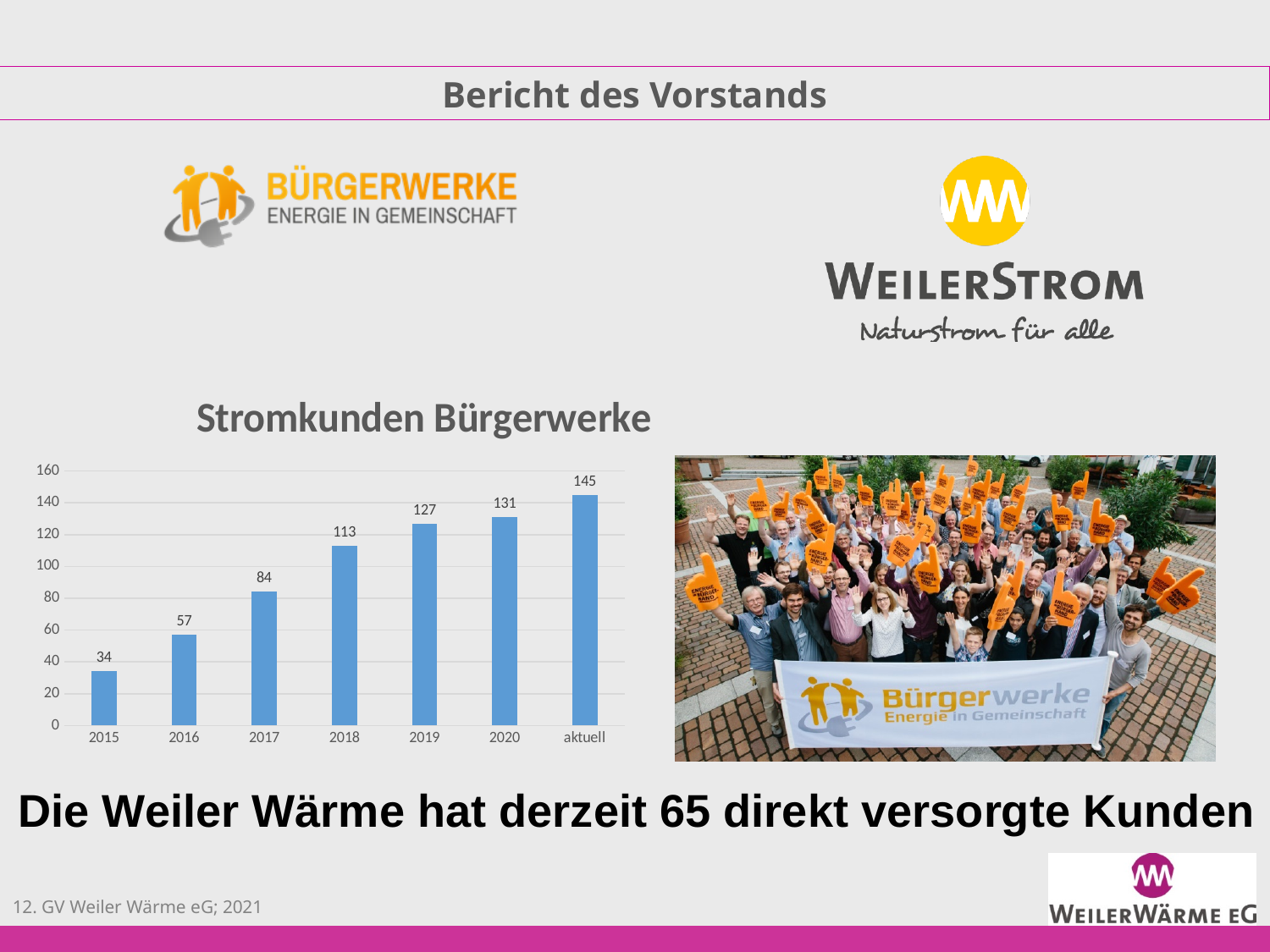
What is the difference between the values for 2017 and 2016 in the Stromkunden Bürgerwerke chart? 27 What is the difference between the values for 2020 and 2019 in the Stromkunden Bürgerwerke chart? 4 Which category has the highest value in the Stromkunden Bürgerwerke chart? aktuell Do the values in the Stromkunden Bürgerwerke chart rise or fall from 2015 to aktuell? rise What is the value for 'aktuell' in the Stromkunden Bürgerwerke chart? 145 How many categories are shown on the x axis of the Stromkunden Bürgerwerke chart? 7 Which category has the lowest value in the Stromkunden Bürgerwerke chart? 2015 What kind of chart is the Stromkunden Bürgerwerke chart? bar chart What is the value for 2018 in the Stromkunden Bürgerwerke chart? 113 Is the value for 2019 in the Stromkunden Bürgerwerke chart greater or less than 120? greater What is the value for 2015 in the Stromkunden Bürgerwerke chart? 34 Which is larger in the Stromkunden Bürgerwerke chart, the value for 2017 or the value for 2018? 2018